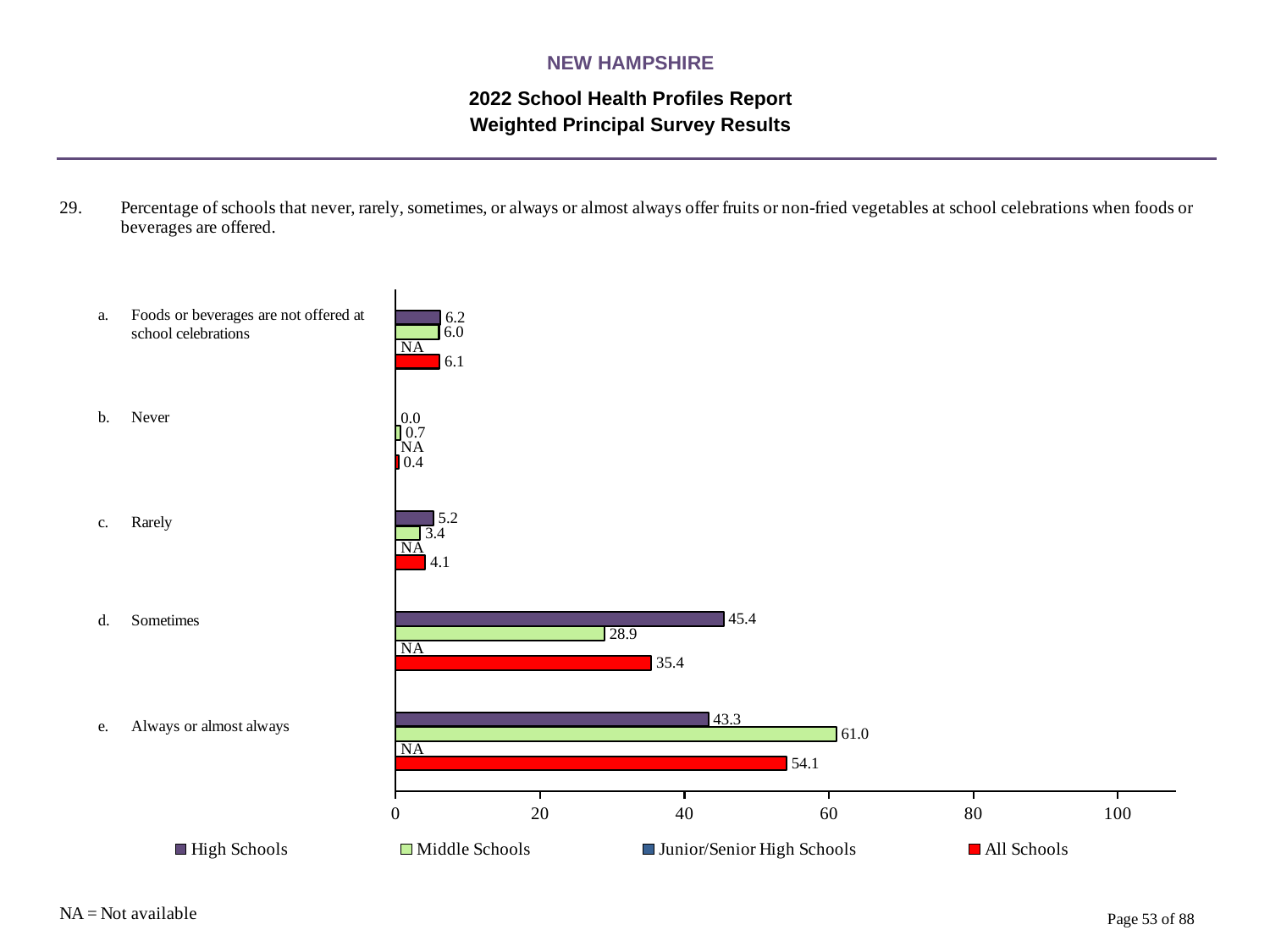
What kind of chart is shown on the slide? Bar chart What is the difference between the Middle Schools and High Schools values for "Always or almost always"? 17.7 For "Sometimes", which is larger: the High Schools value or the Middle Schools value? High Schools Which category has the lowest value for High Schools? Never How many categories are shown on the chart? 5 What is the value for Middle Schools for "Always or almost always"? 61.0 How many series does the legend list? 4 What is the value for High Schools for "Sometimes"? 45.4 What is the value for All Schools for "Rarely"? 4.1 What value is shown for Junior/Senior High Schools in every category? NA Which category has the highest value for All Schools? Always or almost always What is the value for Middle Schools for "Never"? 0.7